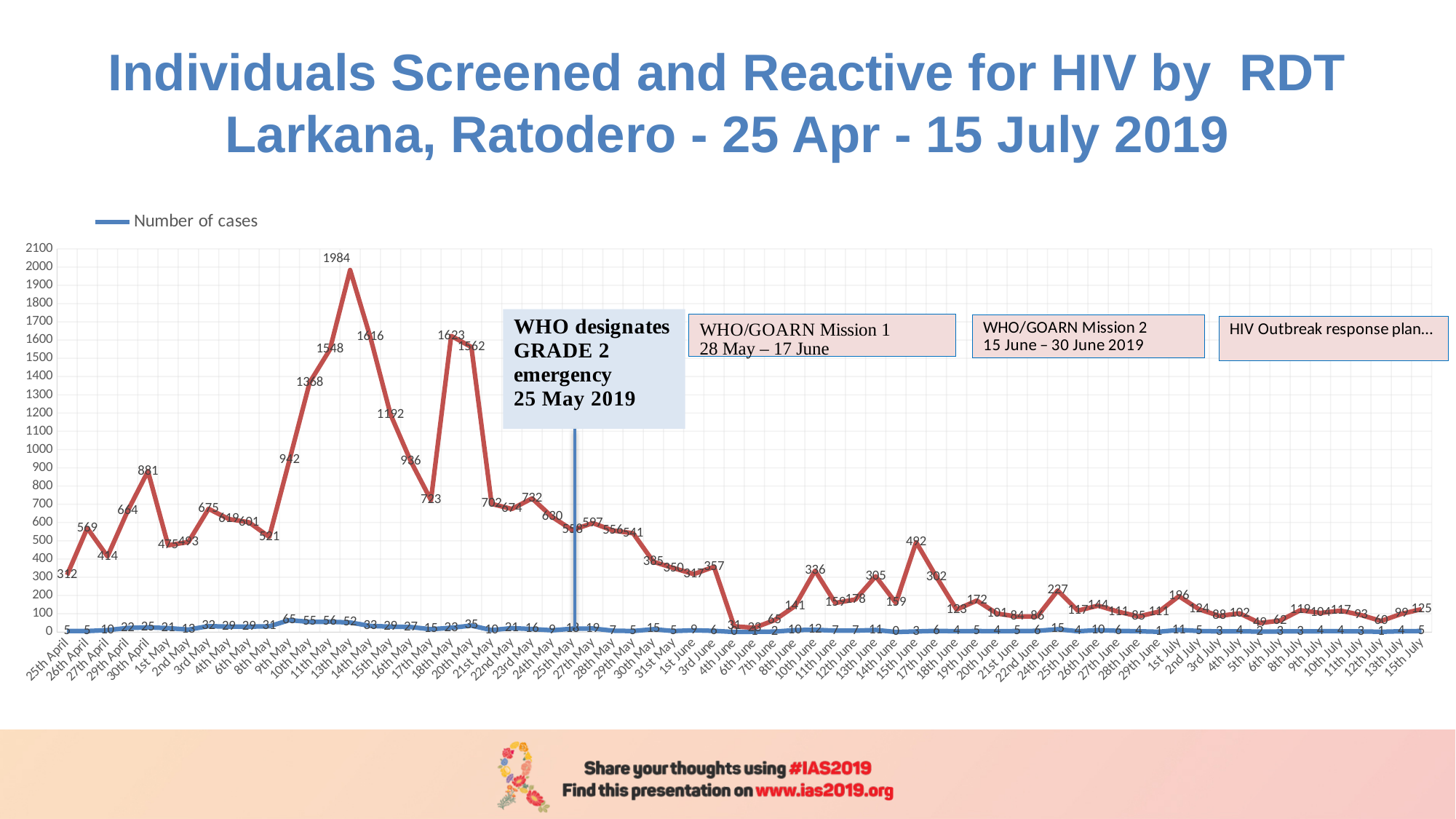
Overall, does the red line (individuals screened) rise or fall from 20th May to 15th July? fall What is the highest value shown on the red line (individuals screened)? 1984 What is the value of the red line (individuals screened) on 15th July, the last date shown? 125 What is the value of the red line (individuals screened) on 30th April? 881 On which date does the red line (individuals screened) reach its highest value? 13th May What is the value of the blue line (Number of cases) on 9th May? 65 What series name is listed in the chart legend? Number of cases What is the value of the red line (individuals screened) on 18th May? 1623 Which is larger on the red line: the value on 10th May or the value on 11th May? 11th May What is the difference between the red line values on 13th May (1984) and 14th May (1616)? 368 Is the value of the red line on 15th June greater or less than 400? greater What kind of chart is shown on the slide? line chart